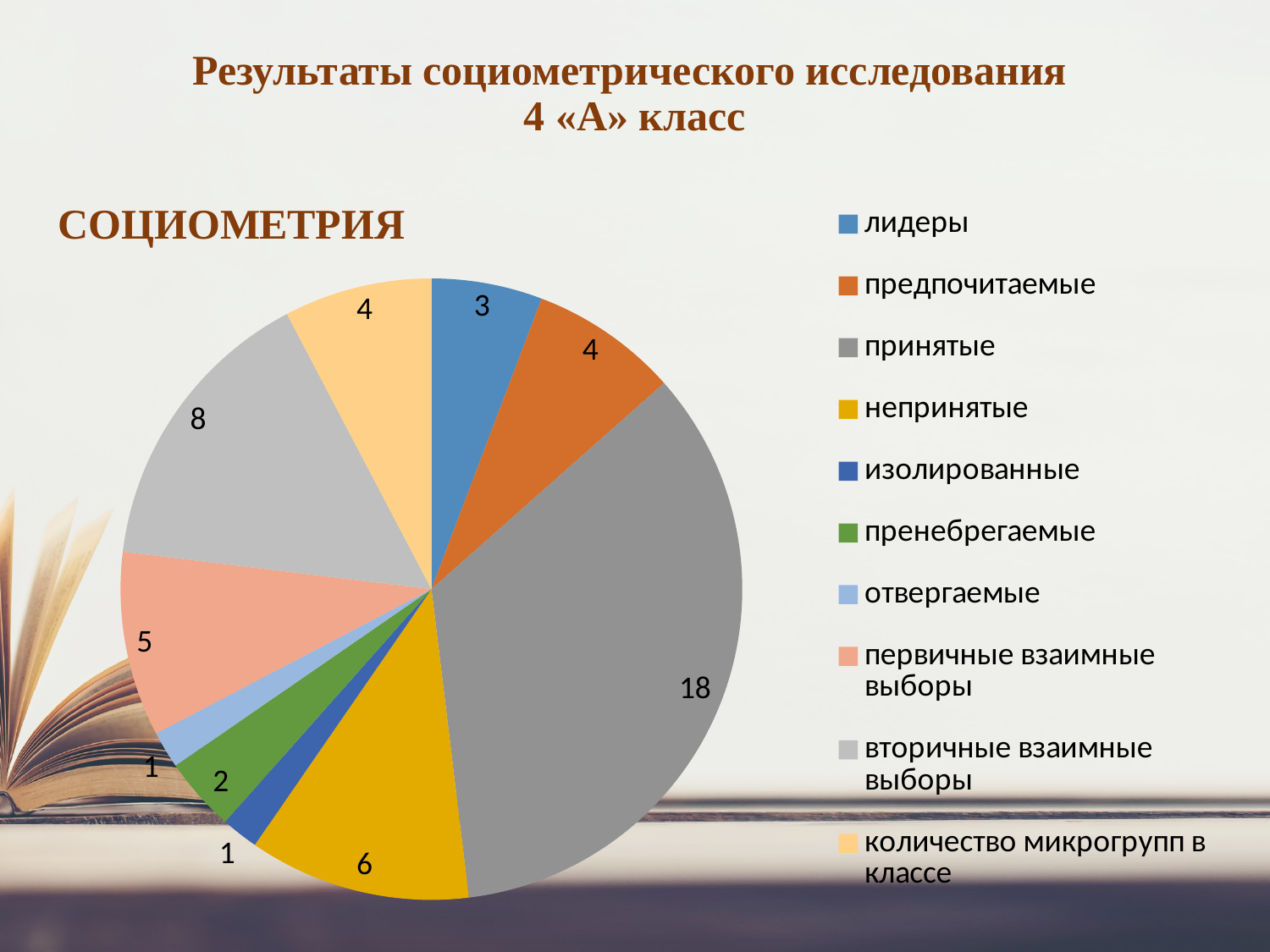
Which is larger, the value for первичные взаимные выборы or the value for пренебрегаемые? первичные взаимные выборы What is the value for лидеры? 3 What is the value for принятые? 18 How many categories does the legend of the chart list? 10 What is the value for непринятые? 6 What is the total of all the slices in the pie? 52 What is the value for количество микрогрупп в классе? 4 What is the difference between the values for принятые and вторичные взаимные выборы? 10 What is the title of the chart? СОЦИОМЕТРИЯ What kind of chart is shown on the slide? pie chart What is the value for вторичные взаимные выборы? 8 Which category has the largest slice of the pie? принятые